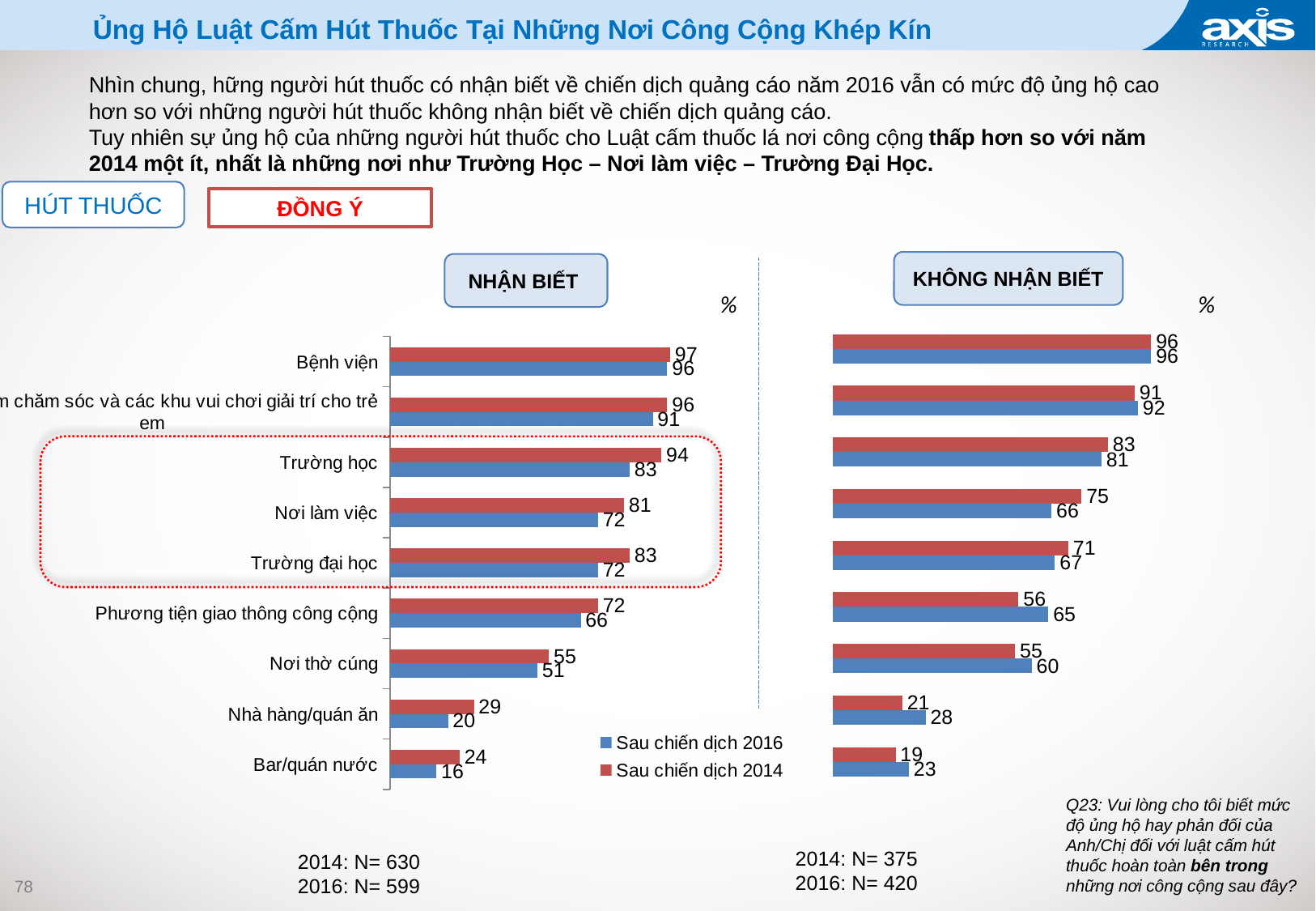
What type of chart is the NHẬN BIẾT chart? Bar chart How many series does the legend list for the charts on this slide? 2 In the NHẬN BIẾT chart, which is larger for Nhà hàng/quán ăn: the Sau chiến dịch 2014 value or the Sau chiến dịch 2016 value? Sau chiến dịch 2014 In the KHÔNG NHẬN BIẾT chart, what is the value for Nơi làm việc in the Sau chiến dịch 2014 series? 75 In the NHẬN BIẾT chart, what is the value for Bệnh viện in the Sau chiến dịch 2014 series? 97 In the KHÔNG NHẬN BIẾT chart, what is the difference between the Sau chiến dịch 2016 and Sau chiến dịch 2014 values for Phương tiện giao thông công cộng? 9 In the NHẬN BIẾT chart, which category has the highest value in the Sau chiến dịch 2014 series? Bệnh viện In the NHẬN BIẾT chart, what is the value for Trường học in the Sau chiến dịch 2016 series? 83 In the NHẬN BIẾT chart, what is the difference between the Sau chiến dịch 2014 and Sau chiến dịch 2016 values for Trường học? 11 In the KHÔNG NHẬN BIẾT chart, which is larger for Nơi thờ cúng: the Sau chiến dịch 2014 value or the Sau chiến dịch 2016 value? Sau chiến dịch 2016 In the NHẬN BIẾT chart, which category has the lowest value in the Sau chiến dịch 2016 series? Bar/quán nước How many categories are shown in the NHẬN BIẾT chart? 9